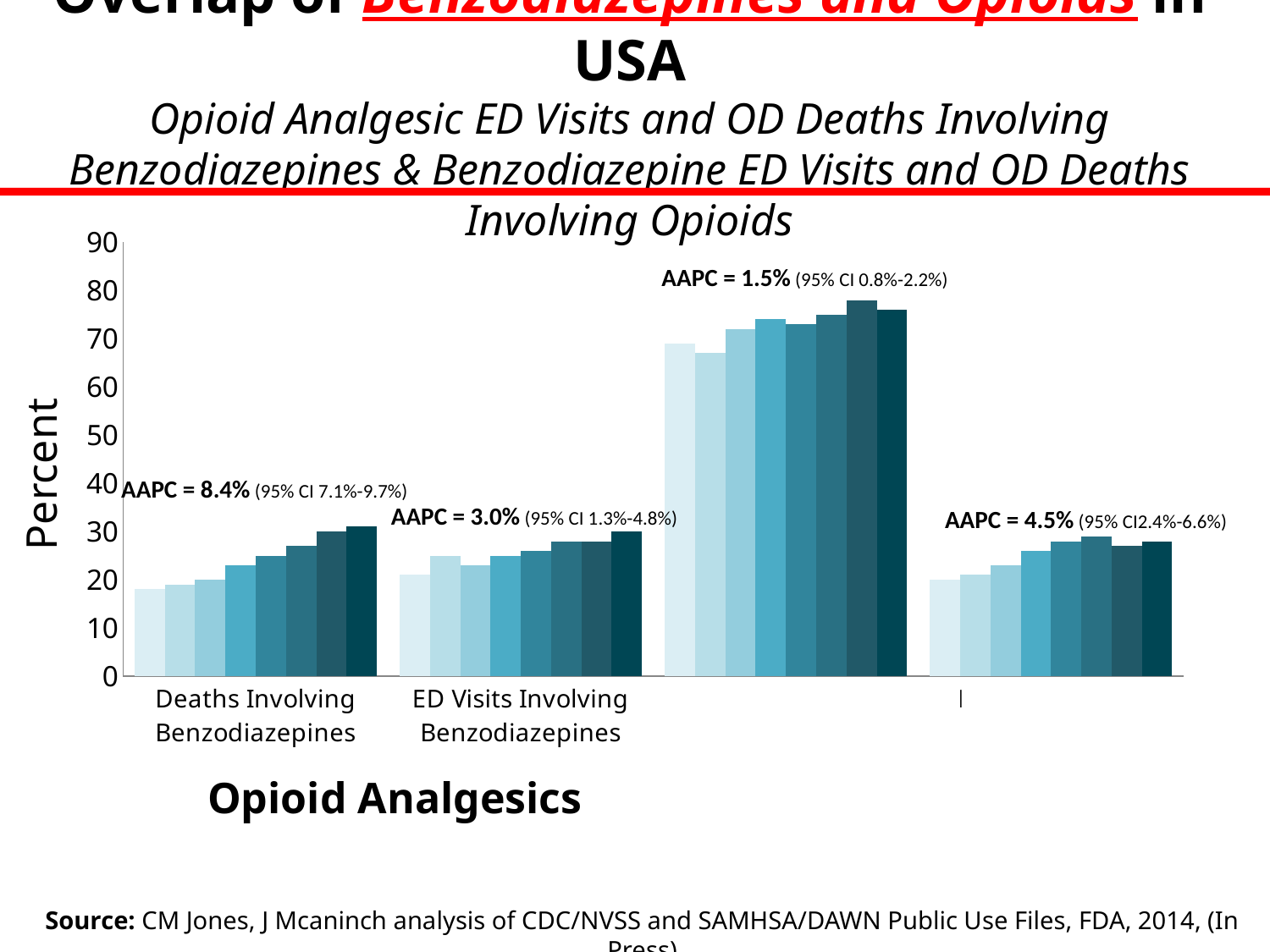
What is the label on the vertical axis of the chart? Percent How many groups of bars does the chart show? 4 What is the 95% confidence interval printed next to AAPC = 1.5%? 0.8%-2.2% What is the AAPC printed for the ED Visits Involving Benzodiazepines group? 3.0% What is the 95% confidence interval printed next to AAPC = 8.4%? 7.1%-9.7% Which AAPC value printed on the chart is the highest? 8.4% Which AAPC value printed on the chart is the lowest? 1.5% What is the AAPC printed for the Deaths Involving Benzodiazepines group? 8.4% Is the tallest bar in the ED Visits Involving Benzodiazepines group greater or less than 40? less Do the bars in the Deaths Involving Benzodiazepines group rise or fall from left to right? rise What kind of chart is shown on the slide? bar chart How many bars are in the Deaths Involving Benzodiazepines group? 8